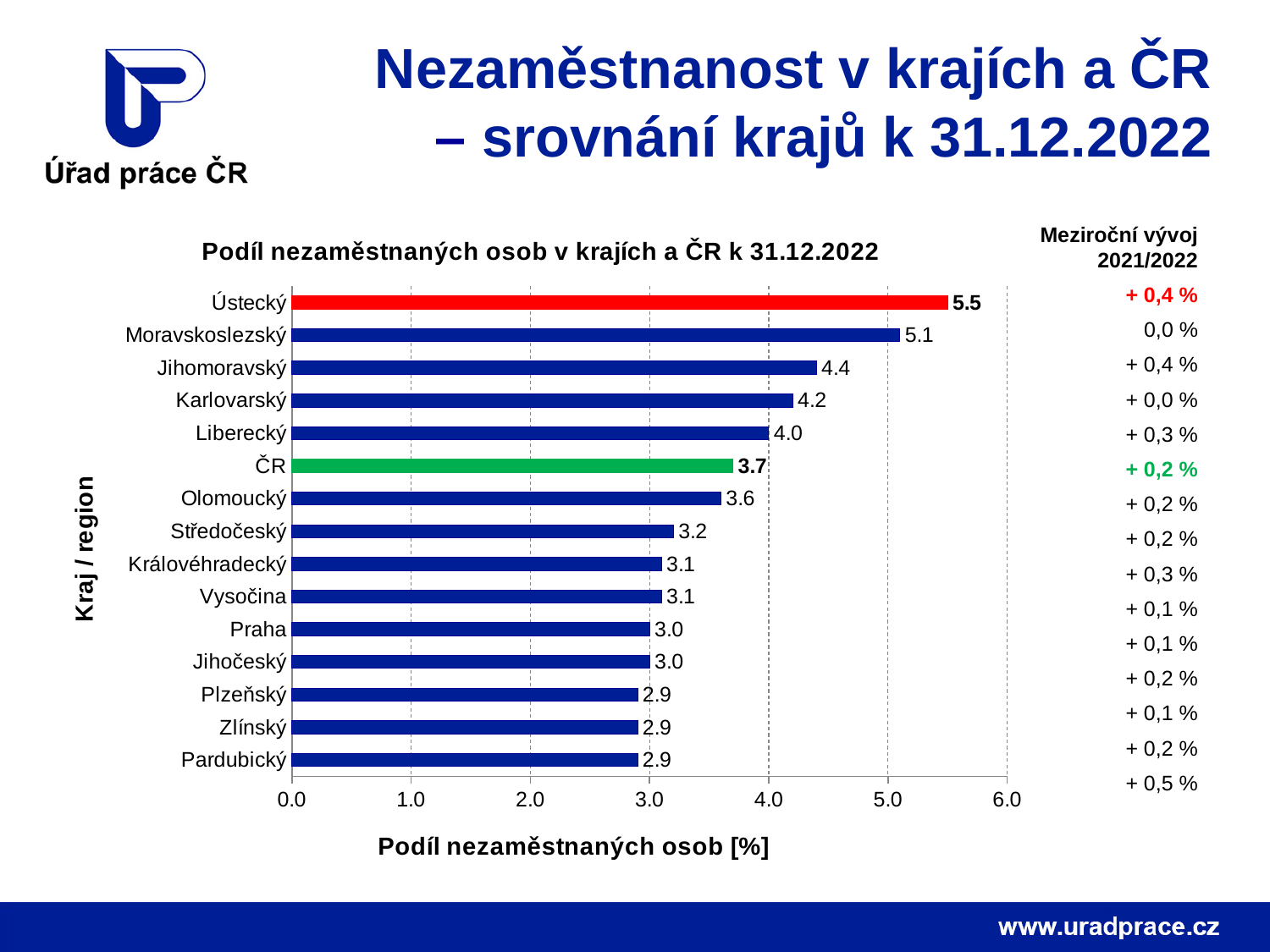
Is the value for Moravskoslezský greater or less than 5.0? greater Which is larger, the value for Karlovarský or the value for Liberecký? Karlovarský What is the difference between the values for Jihomoravský and ČR? 0.7 What kind of chart is shown on the slide? bar chart What is the difference between the values for Ústecký and Moravskoslezský? 0.4 What is the title of the chart? Podíl nezaměstnaných osob v krajích a ČR k 31.12.2022 How many categories are shown in the chart? 15 What colour is the bar for ČR? green What is the value for ČR in the chart? 3.7 What is the value for Olomoucký in the chart? 3.6 What is the value for Ústecký in the chart? 5.5 Which category has the highest value in the chart? Ústecký